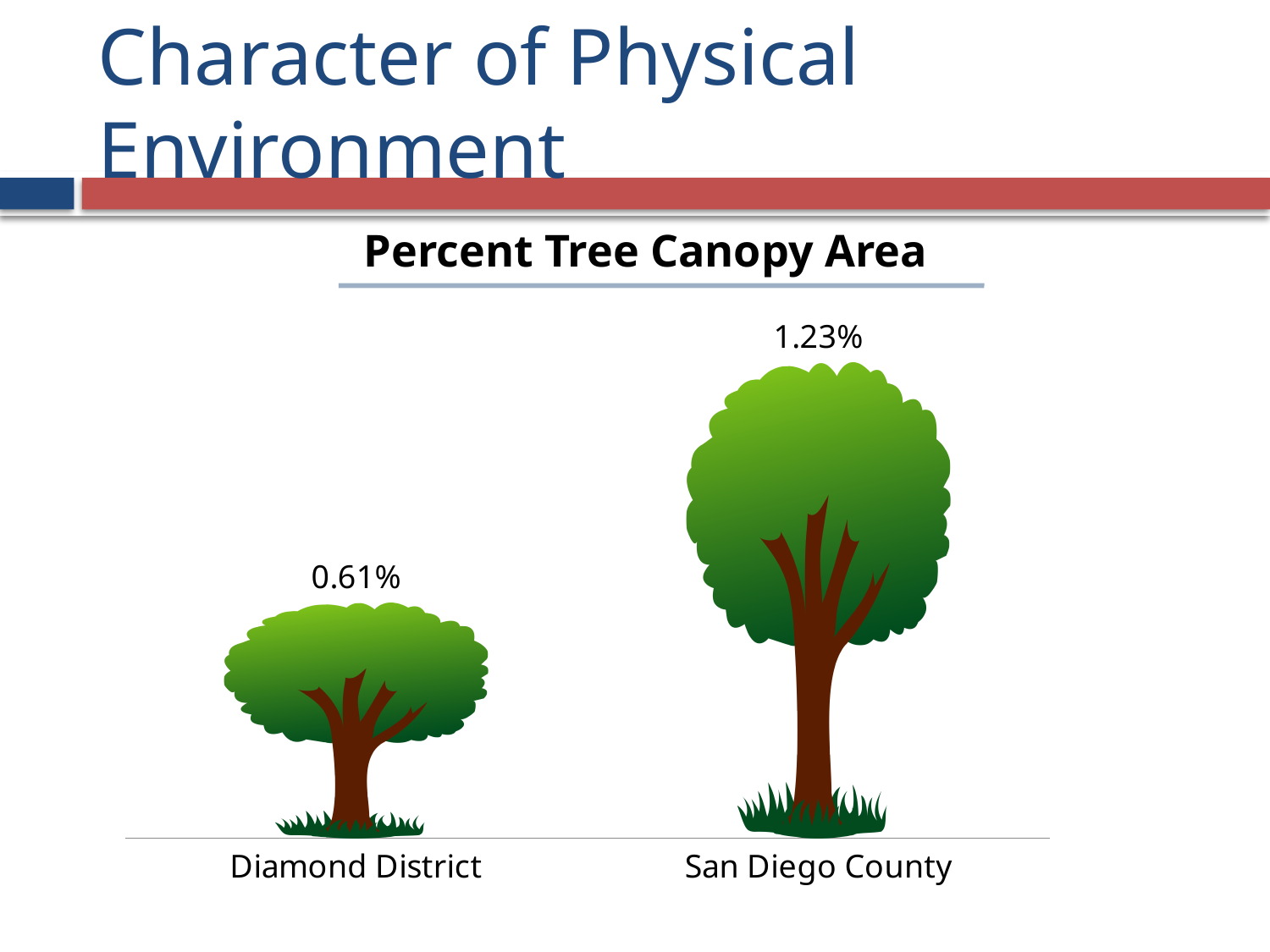
Do the values rise or fall from Diamond District to San Diego County? rise What is the percent tree canopy area for San Diego County? 1.23% Which area has the lower percent tree canopy area? Diamond District What image is used to represent each value in the chart? A tree How many areas are compared in the chart? 2 What is the title of the chart? Percent Tree Canopy Area Is the percent tree canopy area larger for Diamond District or San Diego County? San Diego County Which area has the higher percent tree canopy area? San Diego County What is the difference in percent tree canopy area between San Diego County and Diamond District? 0.62% What is the percent tree canopy area for Diamond District? 0.61%